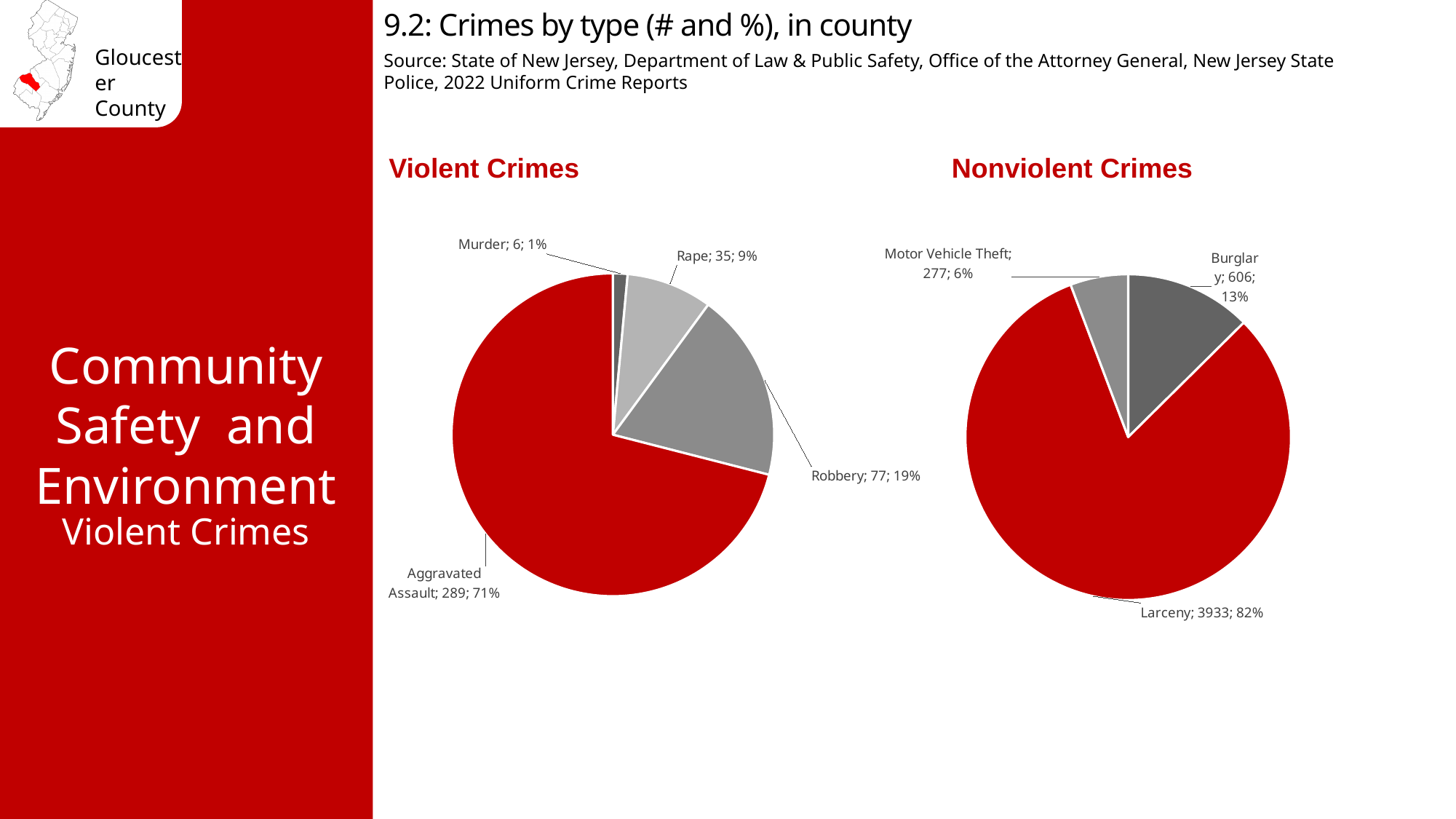
In the Nonviolent Crimes pie chart, what is the difference between the number of burglaries and motor vehicle thefts? 329 In the Nonviolent Crimes pie chart, how many categories are shown? 3 In the Nonviolent Crimes pie chart, what percentage share does Burglary have? 13% In the Nonviolent Crimes pie chart, how many larcenies are shown? 3933 In the Nonviolent Crimes pie chart, which is larger, Burglary or Motor Vehicle Theft? Burglary In the Violent Crimes pie chart, which category has the largest slice? Aggravated Assault In the Violent Crimes pie chart, what percentage share does Robbery have? 19% In the Violent Crimes pie chart, what is the difference between the number of robberies and the number of rapes? 42 What type of chart is used for the Nonviolent Crimes data? Pie chart In the Violent Crimes pie chart, how many aggravated assaults are shown? 289 In the Violent Crimes pie chart, which category has the smallest slice? Murder In the Violent Crimes pie chart, how many categories are shown? 4